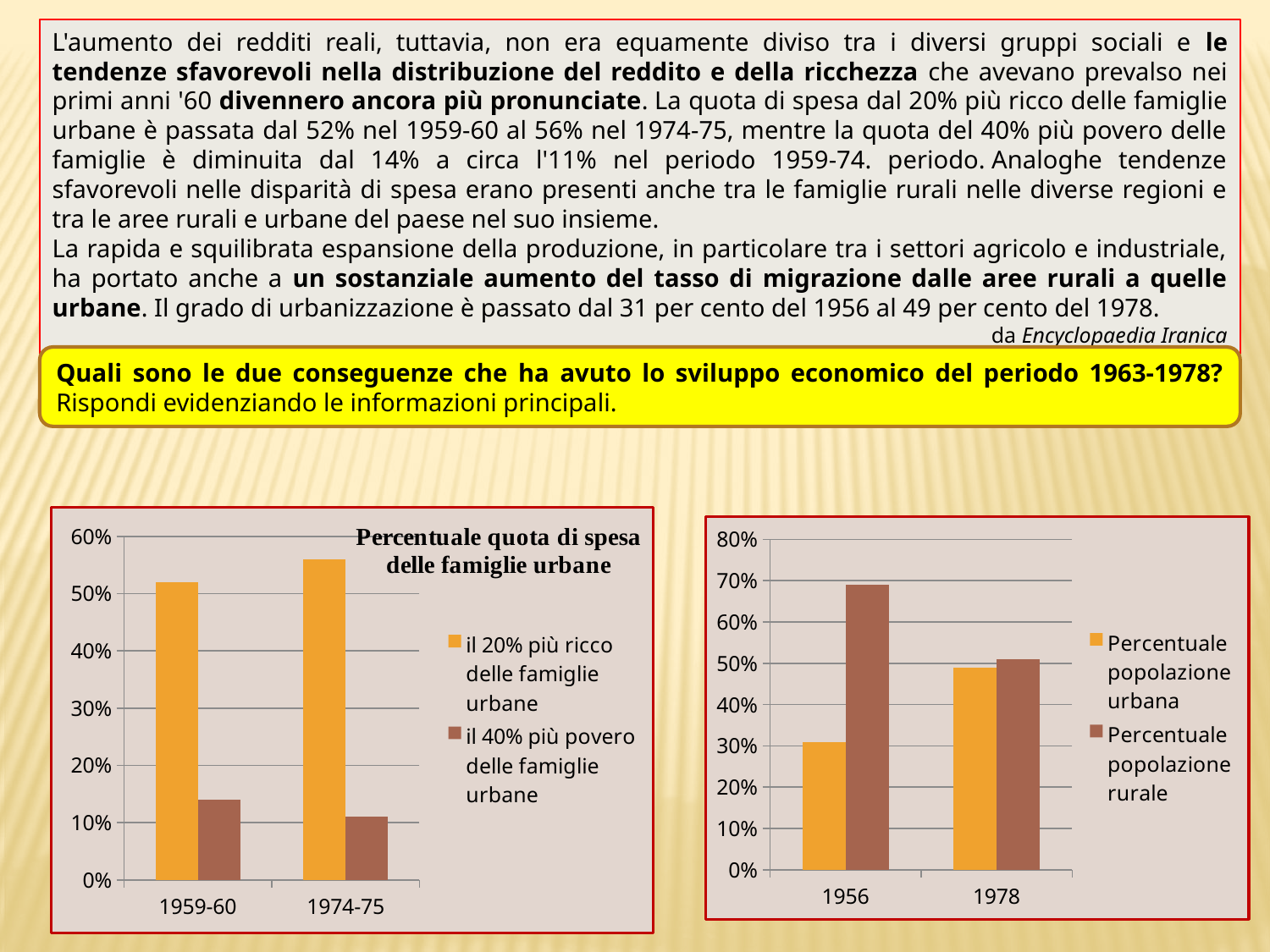
In the left chart 'Percentuale quota di spesa delle famiglie urbane', how many series does the legend list? 2 In the right chart showing urban and rural population percentages, which series has the larger value in 1956? Percentuale popolazione rurale What type of chart is the right chart showing 'Percentuale popolazione urbana' and 'Percentuale popolazione rurale'? bar chart In the left chart 'Percentuale quota di spesa delle famiglie urbane', does the value for 'il 20% più ricco delle famiglie urbane' rise or fall from 1959-60 to 1974-75? rise In the left chart 'Percentuale quota di spesa delle famiglie urbane', is the value for 'il 20% più ricco delle famiglie urbane' in 1959-60 greater or less than 50%? greater In the right chart showing urban and rural population percentages, how many series does the legend list? 2 In the right chart showing urban and rural population percentages, does the value for 'Percentuale popolazione urbana' rise or fall from 1956 to 1978? rise In the left chart 'Percentuale quota di spesa delle famiglie urbane', does the value for 'il 40% più povero delle famiglie urbane' rise or fall from 1959-60 to 1974-75? fall In the left chart 'Percentuale quota di spesa delle famiglie urbane', how many periods are shown on the x axis? 2 What type of chart is the left chart titled 'Percentuale quota di spesa delle famiglie urbane'? bar chart In the right chart showing urban and rural population percentages, is the value for 'Percentuale popolazione rurale' in 1956 greater or less than 60%? greater In the left chart 'Percentuale quota di spesa delle famiglie urbane', which series has the larger value in 1974-75? il 20% più ricco delle famiglie urbane